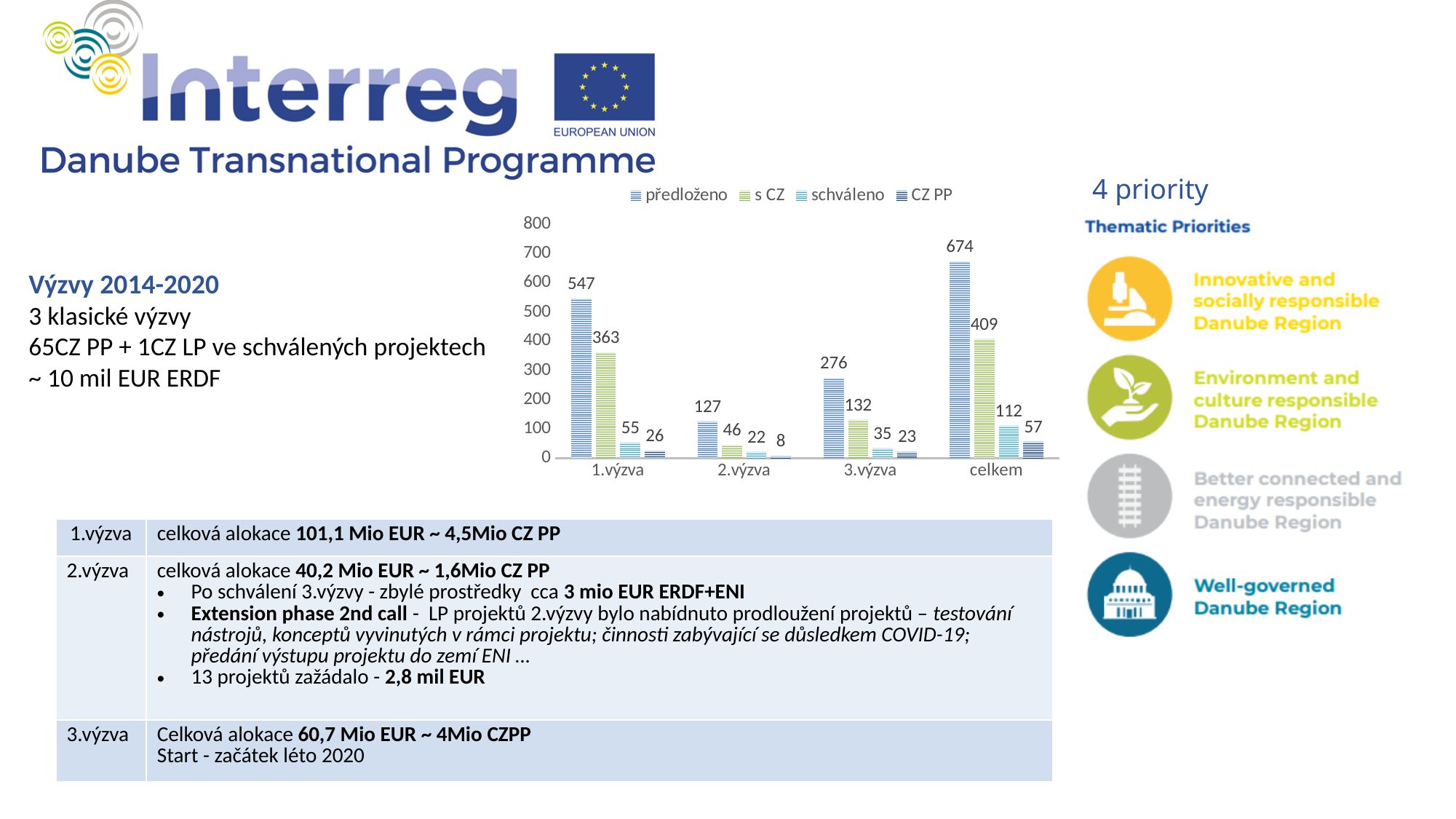
Which is larger: s CZ for 1.výzva or předloženo for 3.výzva? s CZ for 1.výzva How many categories are shown on the x axis of the chart? 4 Which series is shown in green in the chart legend? s CZ What is the value of CZ PP for 2.výzva? 8 What type of chart is shown on the slide? bar chart How many series does the chart legend list? 4 What is the difference between předloženo and s CZ for 3.výzva? 144 What is the value of schváleno for 3.výzva? 35 Which category has the highest value for schváleno? celkem What is the value of předloženo for 1.výzva? 547 What is the value of s CZ for celkem? 409 Which category has the lowest value for předloženo? 2.výzva